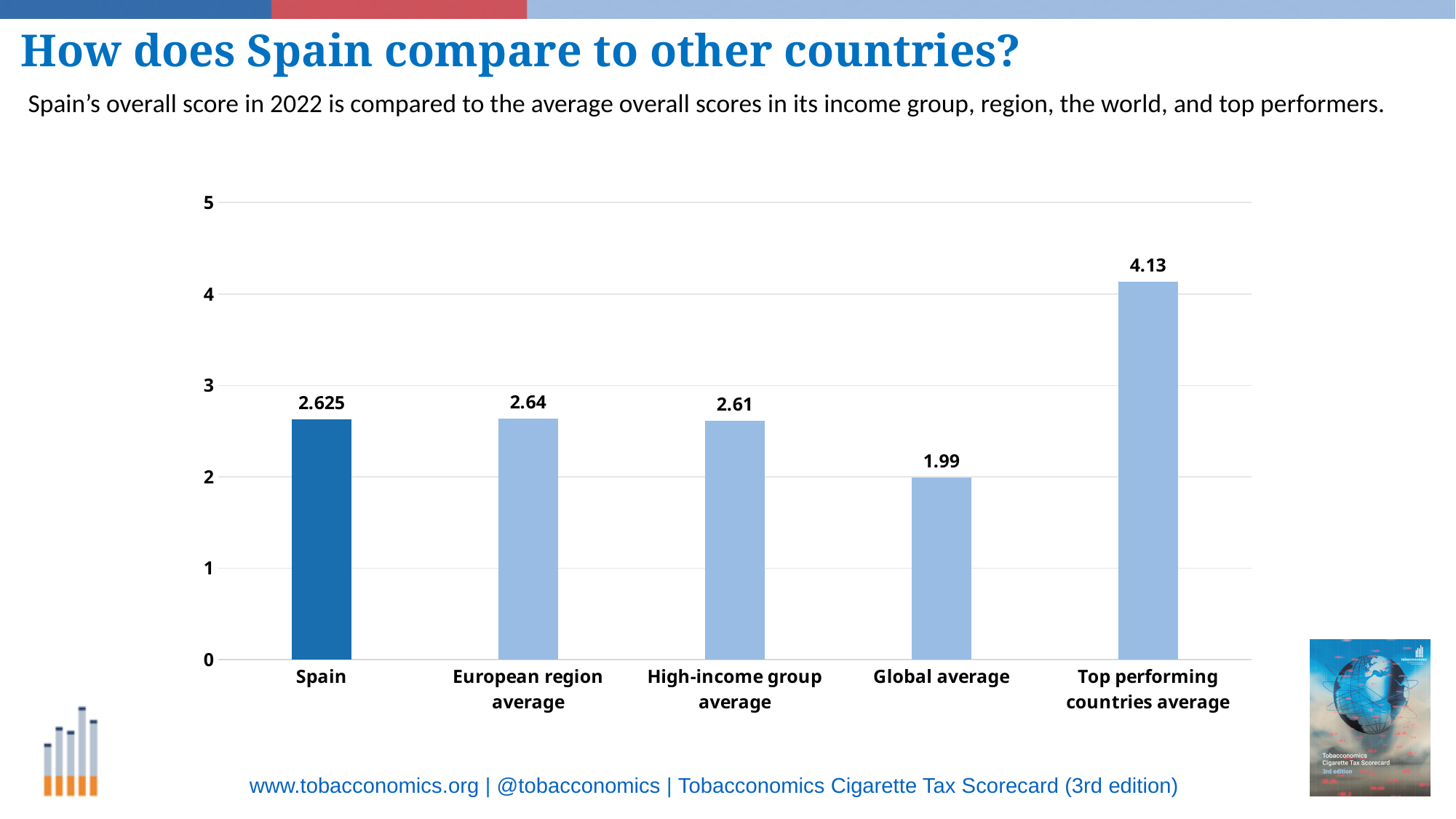
What kind of chart is shown on the slide? Bar chart What is the difference between the Top performing countries average and Spain? 1.505 Which category has the highest value? Top performing countries average How many categories are shown in the chart? 5 What is the value for the Top performing countries average? 4.13 Which is larger, the value for Spain or the Global average? Spain Which category has the lowest value? Global average What is the value for the Global average? 1.99 What is the value for the High-income group average? 2.61 What is the difference between the European region average and the Global average? 0.65 What is the value for Spain? 2.625 What is the value for the European region average? 2.64